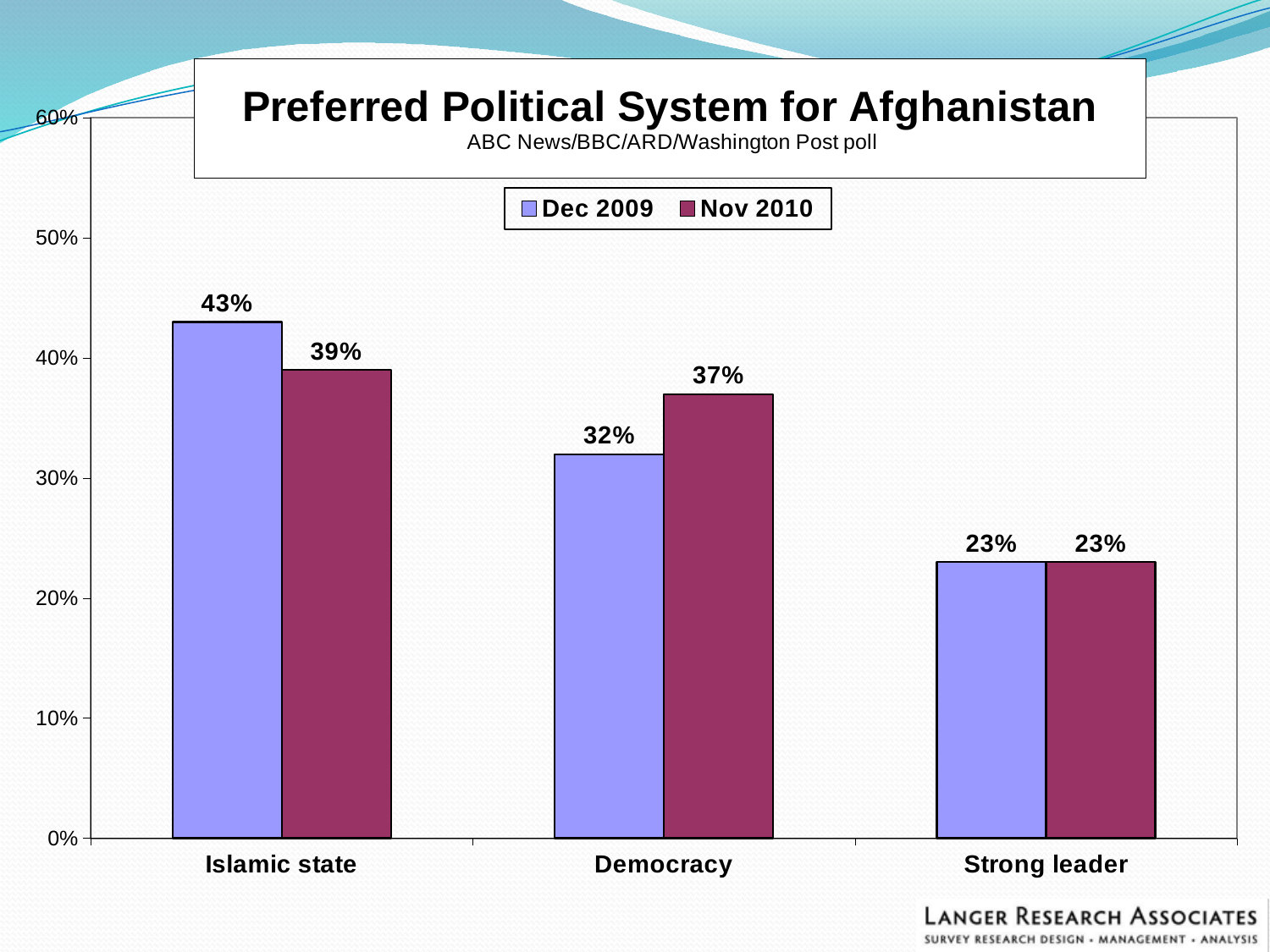
What is the difference between the Dec 2009 and Nov 2010 values for Democracy? 5% What kind of chart is shown on the slide? Bar chart What is the title of the chart? Preferred Political System for Afghanistan Which is larger for Islamic state: the Dec 2009 value or the Nov 2010 value? Dec 2009 How many series does the legend list? 2 Which category has the highest Dec 2009 value? Islamic state Which category has the lowest Nov 2010 value? Strong leader What is the Dec 2009 value for Islamic state? 43% How many categories are shown on the x axis? 3 What is the Dec 2009 value for Strong leader? 23% Do the Dec 2009 values rise or fall from Islamic state to Strong leader? Fall What is the Nov 2010 value for Democracy? 37%